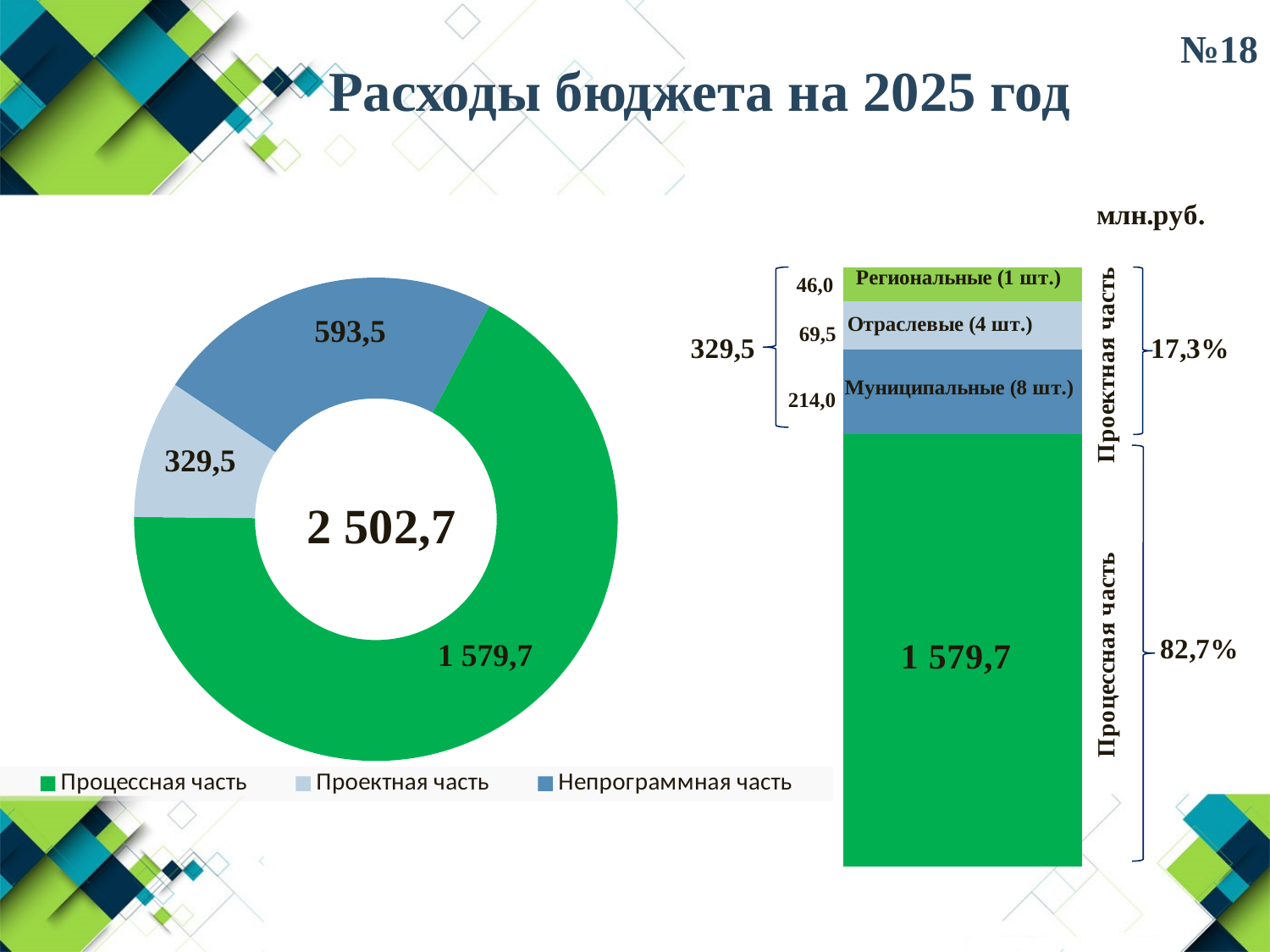
In the donut chart on the left, what total is shown in the centre? 2 502,7 In the stacked bar chart on the right, what is the value for Муниципальные (8 шт.)? 214,0 In the donut chart on the left, what is the value for Непрограммная часть? 593,5 In the stacked bar chart on the right, what is the value for Региональные (1 шт.)? 46,0 How many entries does the legend of the donut chart on the left list? 3 In the donut chart on the left, which category has the largest value? Процессная часть In the stacked bar chart on the right, what percentage share is shown for Процессная часть? 82,7% In the donut chart on the left, what is the difference between Непрограммная часть and Проектная часть? 264,0 In the donut chart on the left, what is the value for Проектная часть? 329,5 In the stacked bar chart on the right, which is larger: Отраслевые (4 шт.) or Муниципальные (8 шт.)? Муниципальные (8 шт.) In the donut chart on the left, which category has the smallest value? Проектная часть In the stacked bar chart on the right, what is the difference between Отраслевые (4 шт.) and Региональные (1 шт.)? 23,5